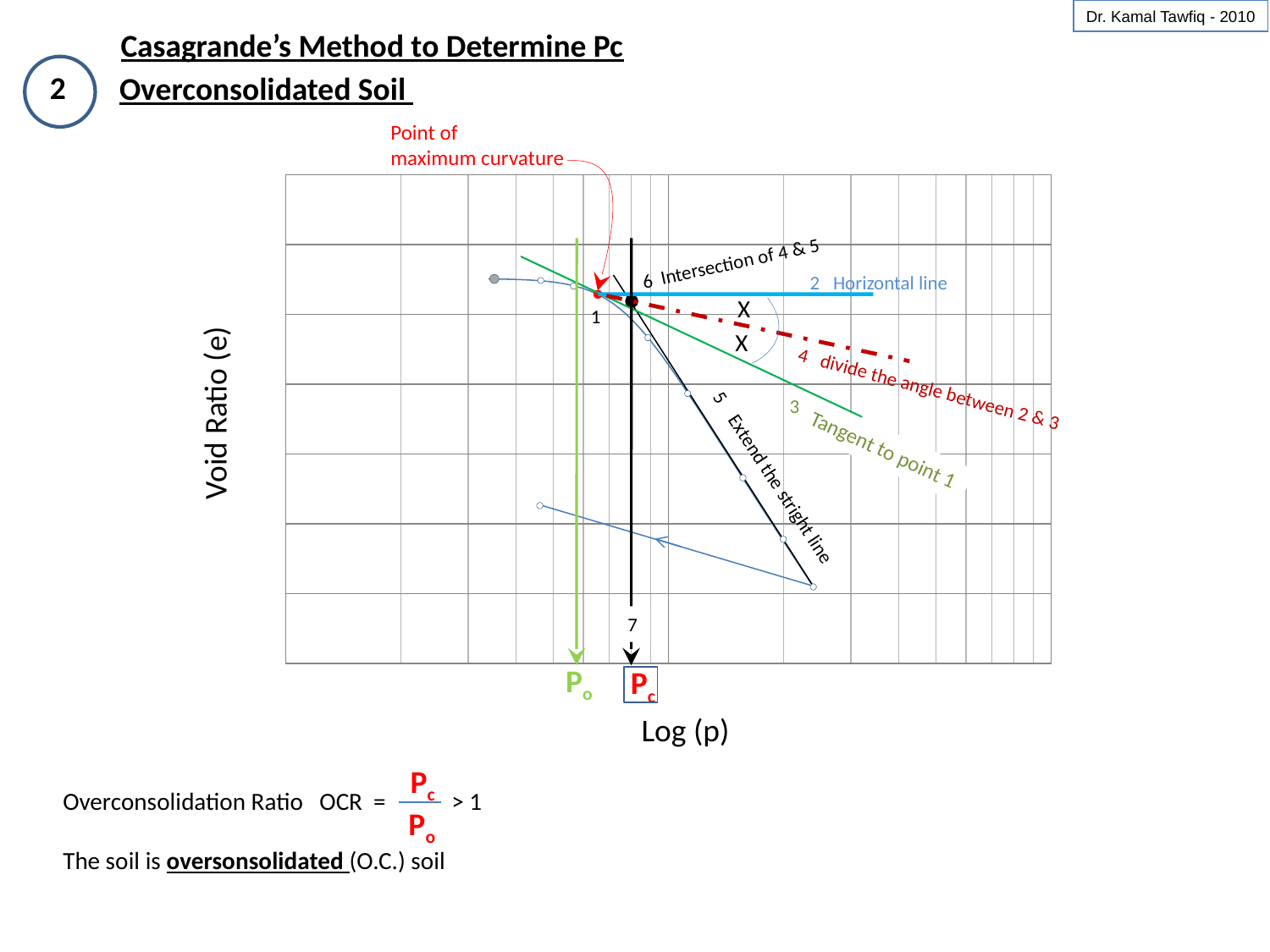
What kind of chart is shown on the slide? line chart What is the label of the horizontal axis of the chart? Log (p) Along the main curve, does the void ratio rise or fall as Log (p) increases? fall According to the chart, is Pc larger or smaller than Po? larger What is the label of the vertical axis of the chart? Void Ratio (e) Which pressure is located further to the right on the Log (p) axis, Po or Pc? Pc